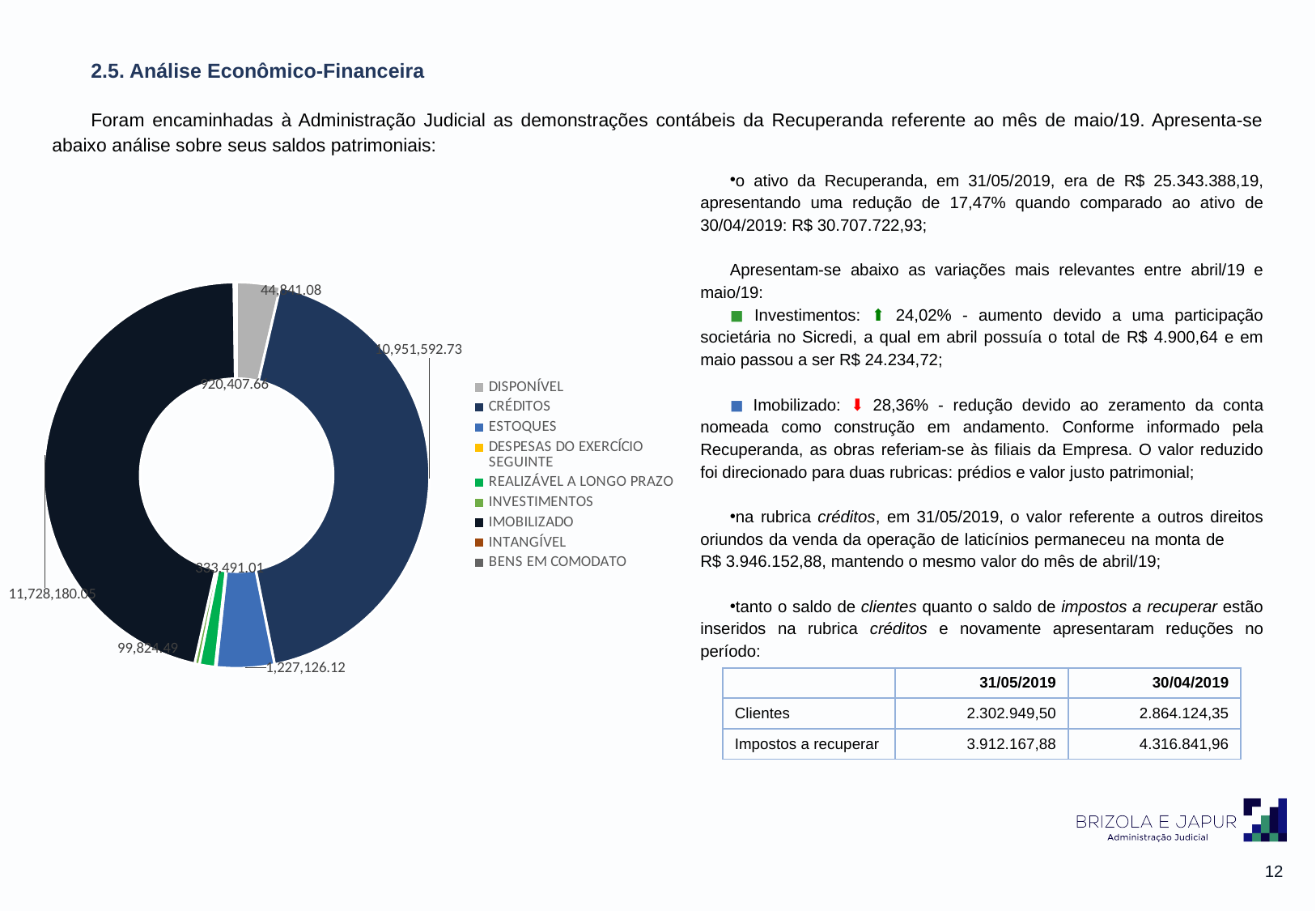
Which legend entry in the chart is shown in black? IMOBILIZADO What is the difference between the ESTOQUES value and the DISPONÍVEL value in the chart? 306,718.46 Which is larger in the chart, CRÉDITOS or ESTOQUES? CRÉDITOS Which is larger in the chart, DISPONÍVEL or ESTOQUES? ESTOQUES What kind of chart is shown on the slide? Doughnut (pie) chart What is the value shown for DISPONÍVEL in the chart? 920,407.66 How many entries does the chart legend list? 9 Which legend entry in the chart is shown in grey? DISPONÍVEL What is the value shown for ESTOQUES in the chart? 1,227,126.12